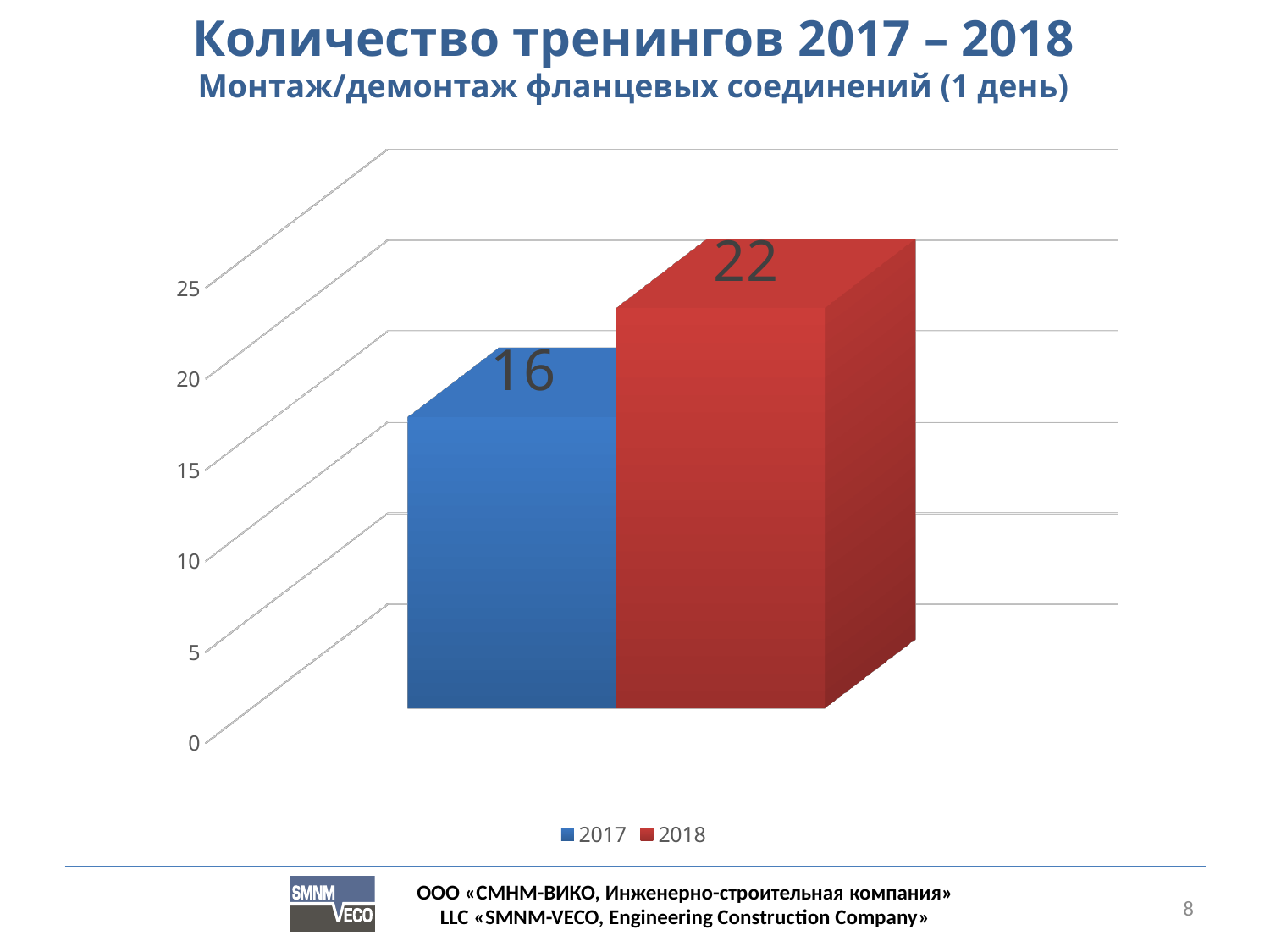
What colour is the bar for 2018? red What is the value for 2017? 16 Which year has the higher value, 2017 or 2018? 2018 Is the value for 2018 greater or less than 20? greater What kind of chart is shown on the slide? bar chart What is the title of the slide? Количество тренингов 2017 – 2018 What is the value for 2018? 22 Which series has the highest value? 2018 Which series has the lowest value? 2017 How many series does the legend list? 2 Is the value for 2017 greater or less than 20? less What is the difference between the values for 2018 and 2017? 6